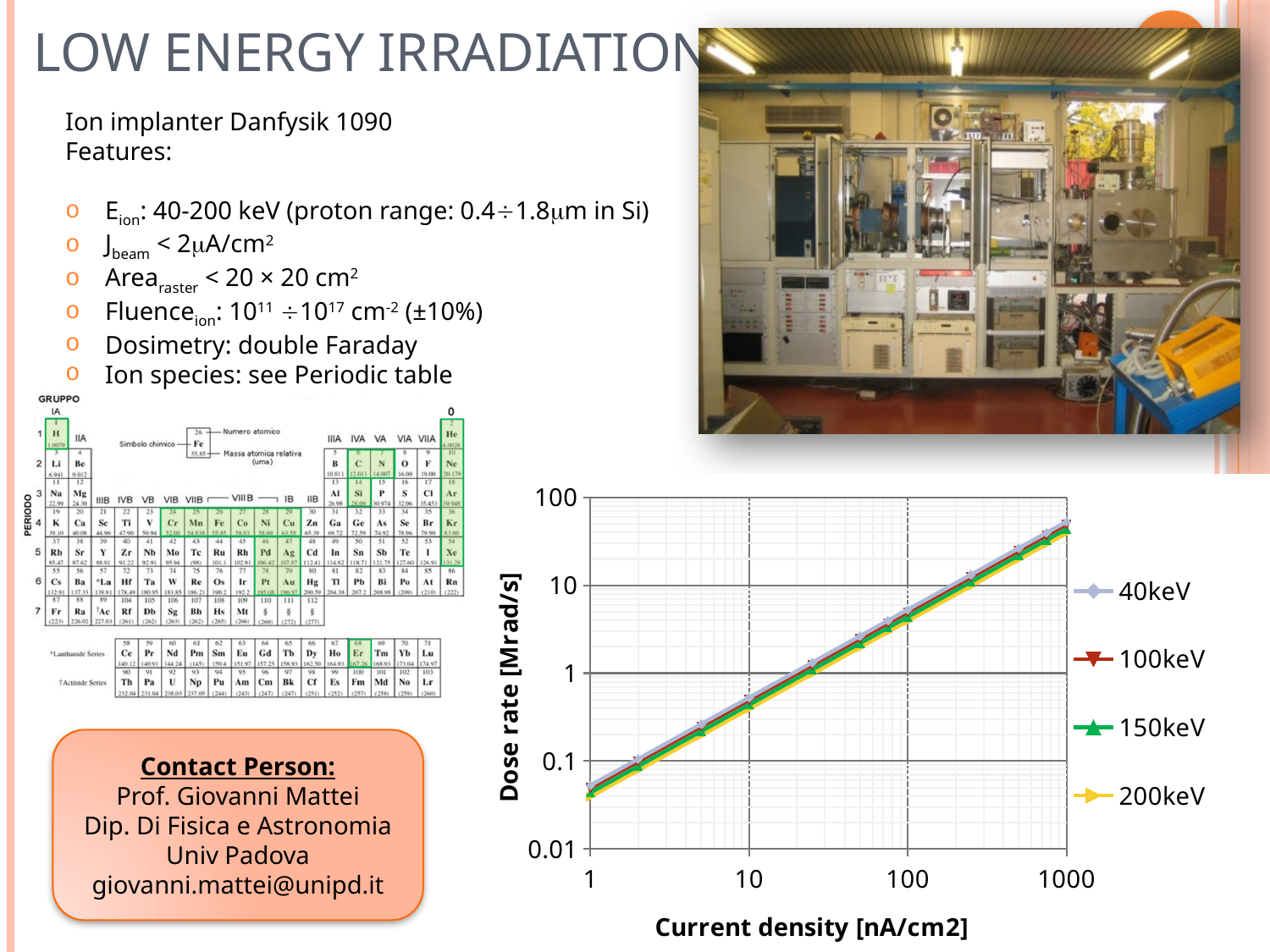
In the dose rate chart, is the 100keV dose rate at a current density of 10 nA/cm2 greater or less than 1 Mrad/s? less What is the highest value shown on the x axis of the dose rate chart? 1000 What is the label of the y axis of the dose rate chart? Dose rate [Mrad/s] In the dose rate chart, does the dose rate rise or fall as current density increases? rise In the dose rate chart, is the 150keV dose rate at a current density of 100 nA/cm2 greater or less than 1 Mrad/s? greater What is the label of the x axis of the dose rate chart? Current density [nA/cm2] In the dose rate chart, is the 40keV dose rate at a current density of 1000 nA/cm2 greater or less than 10 Mrad/s? greater How many series does the legend of the dose rate chart list? 4 What kind of chart is shown at the bottom right of the slide? line chart